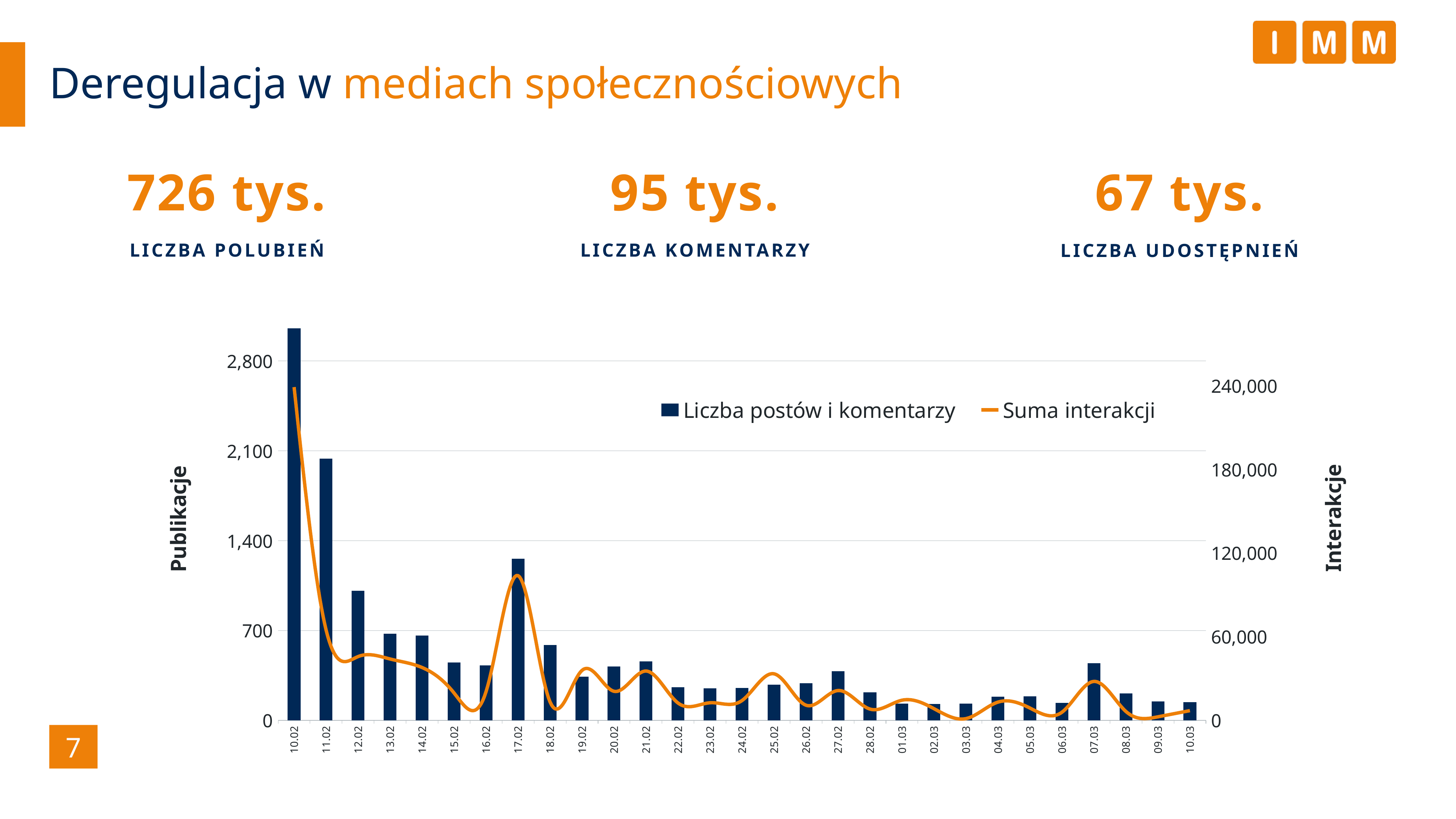
Is the Suma interakcji value for 17.02 greater or less than 60,000? greater What are the two series named in the chart legend? Liczba postów i komentarzy and Suma interakcji Is the Liczba postów i komentarzy value for 17.02 greater or less than 1,400? less Overall, do the Liczba postów i komentarzy values rise or fall from 10.02 to 10.03? fall How many dates are shown on the x axis of the chart? 29 Is the Liczba postów i komentarzy value for 11.02 greater or less than 1,400? greater On which date is the bar for Liczba postów i komentarzy the highest? 10.02 How many series does the chart legend list? 2 What kind of chart is shown on the slide? A bar chart combined with a line Which has the larger Liczba postów i komentarzy value, 12.02 or 17.02? 17.02